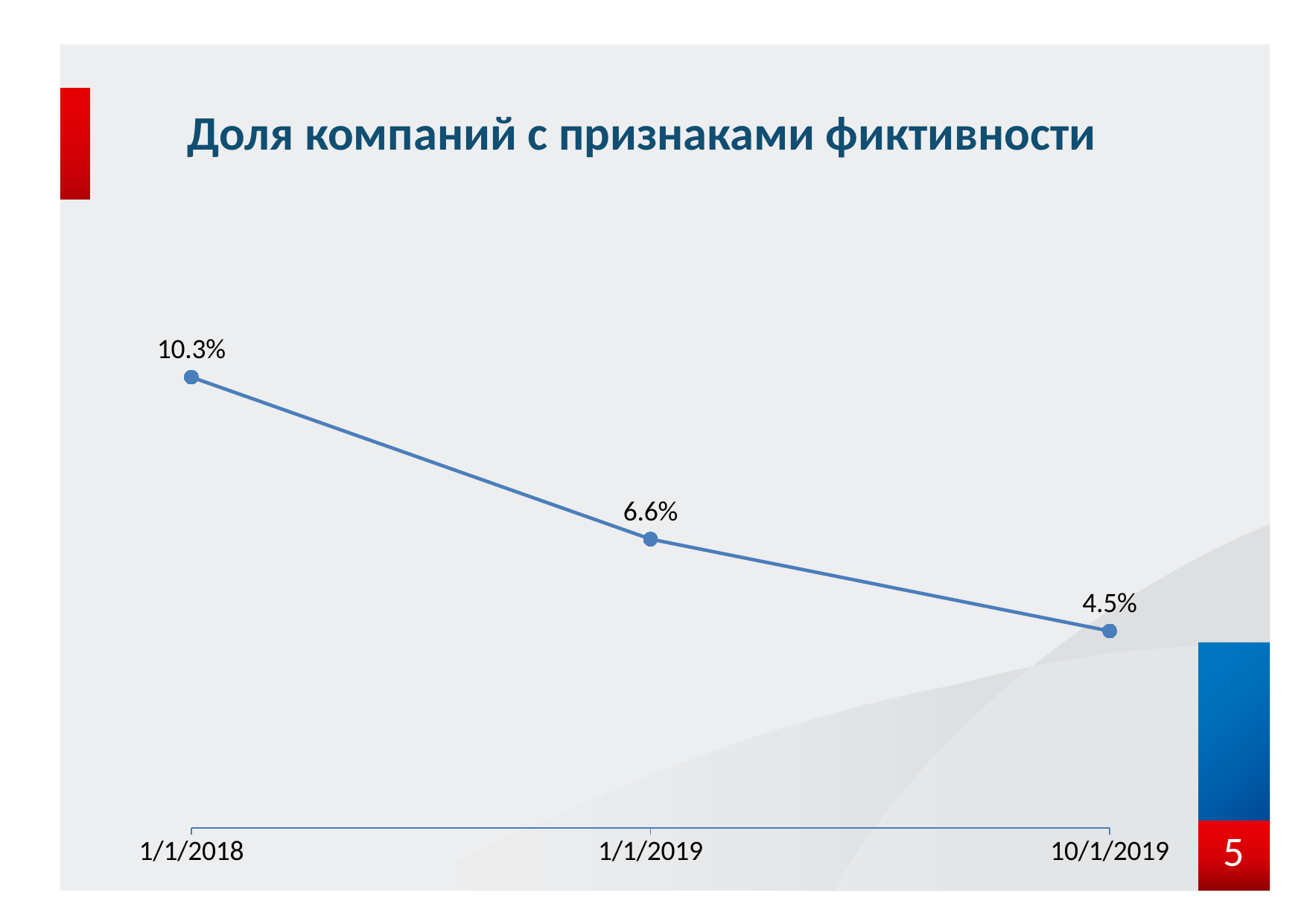
What is the difference between the values for 1/1/2019 and 10/1/2019? 2.1% What kind of chart is shown on the slide? line chart Which date has the lowest value? 10/1/2019 What is the title of the slide? Доля компаний с признаками фиктивности What is the value for 10/1/2019? 4.5% Which date has the highest value? 1/1/2018 Do the values rise or fall from 1/1/2018 to 10/1/2019? fall How many data points are plotted on the chart? 3 What is the value for 1/1/2019? 6.6% What is the value for 1/1/2018? 10.3% What is the difference between the values for 1/1/2018 and 1/1/2019? 3.7% Which is larger, the value for 1/1/2019 or the value for 10/1/2019? 1/1/2019